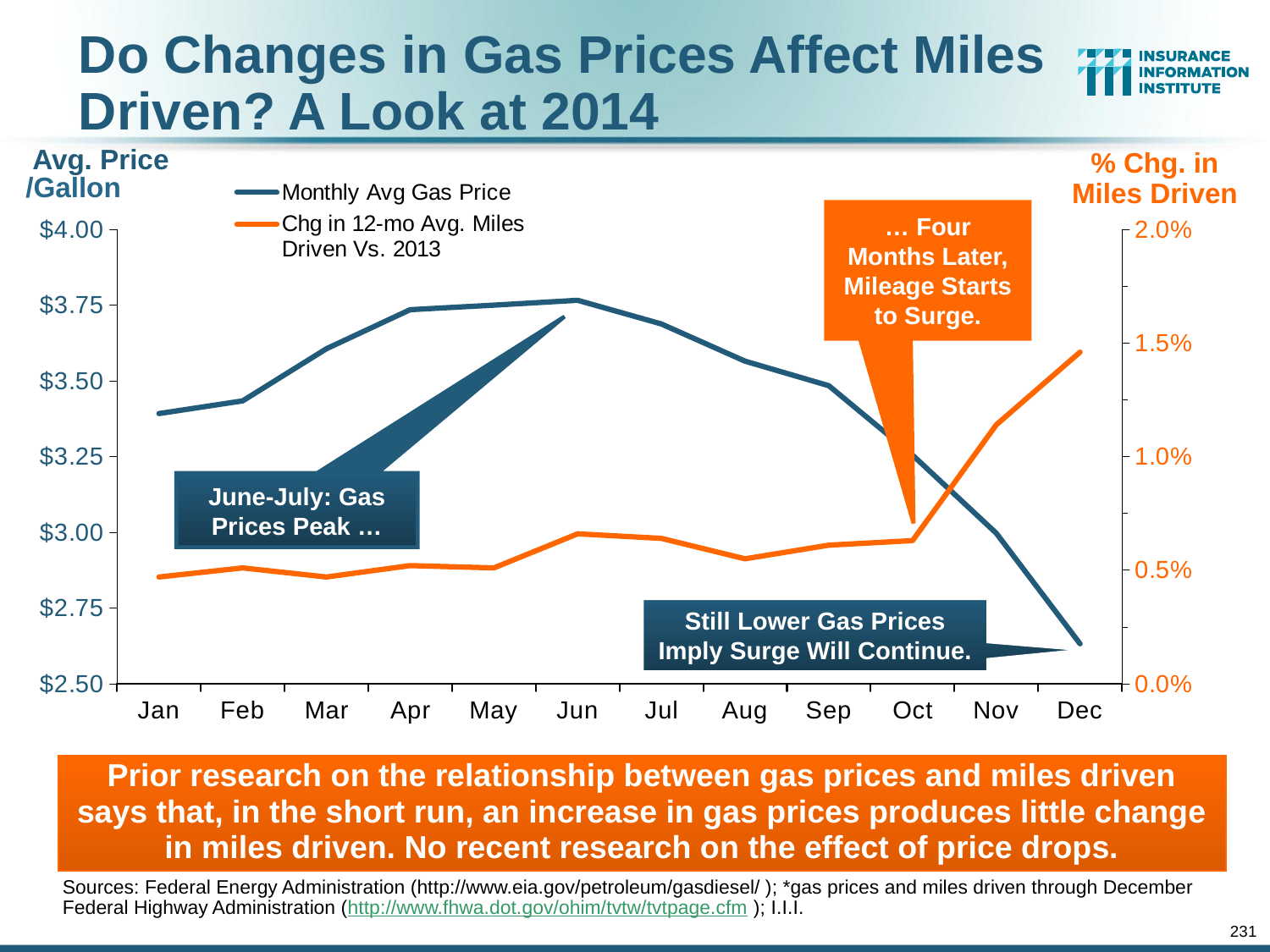
Which month has the higher Monthly Avg Gas Price, Jan or Dec? Jan What is the label of the right-hand vertical axis? % Chg. in Miles Driven Is the Chg in 12-mo Avg. Miles Driven Vs. 2013 for Oct greater or less than 1.0%? less How many series does the chart's legend list? 2 Is the Monthly Avg Gas Price for Dec greater or less than $2.75? less How many months are plotted along the x axis? 12 Is the Monthly Avg Gas Price for Jan greater or less than $3.25? greater What kind of chart is shown on the slide? Line chart In which month is the Monthly Avg Gas Price lowest? Dec Does the Monthly Avg Gas Price rise or fall from Jun to Dec? Fall In which month is the Chg in 12-mo Avg. Miles Driven Vs. 2013 highest? Dec